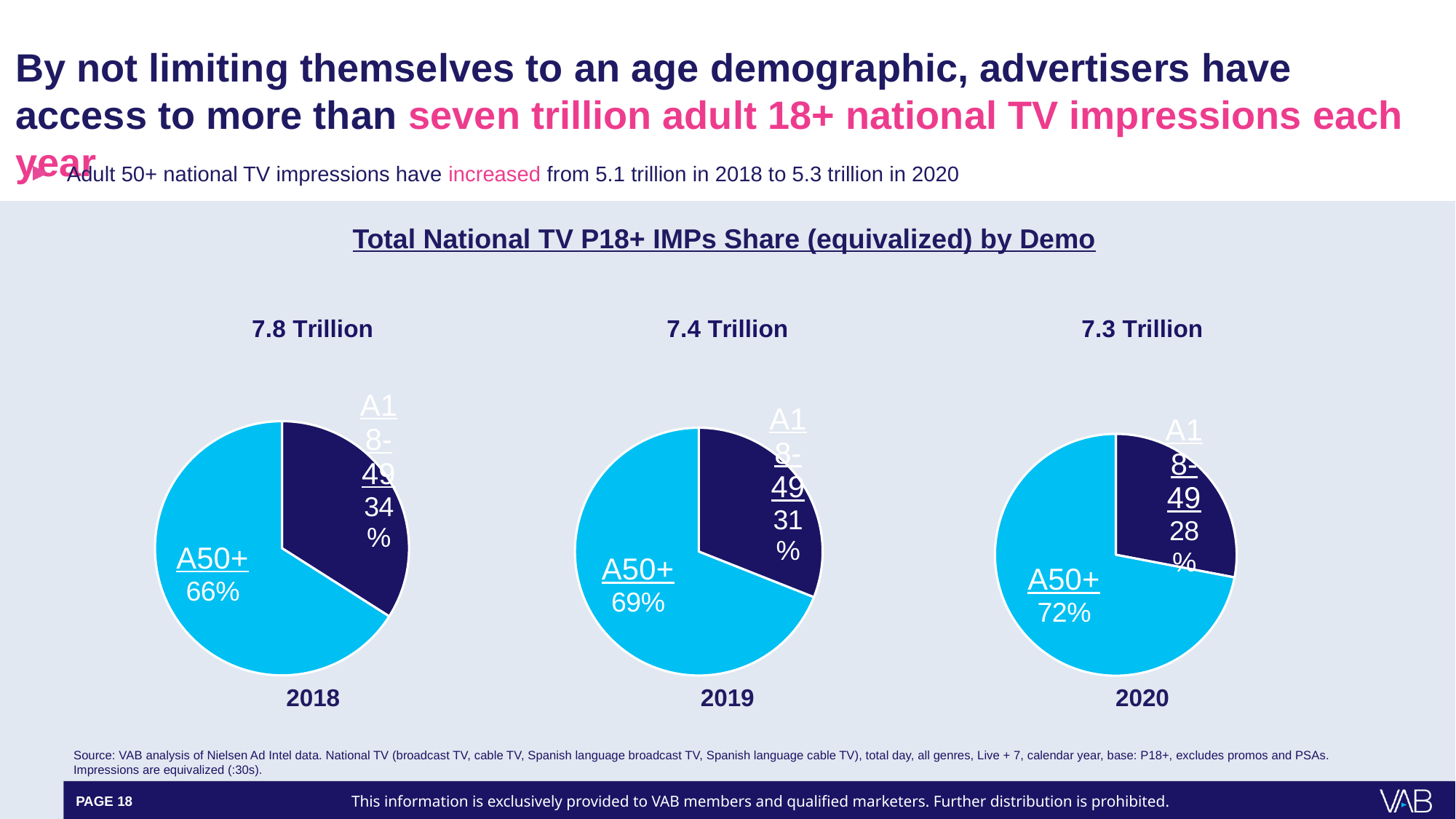
What is the title shown above the three pie charts? Total National TV P18+ IMPs Share (equivalized) by Demo In the 2020 pie chart, what share is shown for A50+? 72% In the 2020 pie chart, what is the difference in percentage points between the A50+ share and the A18-49 share? 44 In the 2018 pie chart, what share is shown for A50+? 66% Across the three pie charts, does the A50+ share rise or fall from 2018 to 2020? rise In the 2020 pie chart, what share is shown for A18-49? 28% What type of chart is used for the 2019 data? pie chart What total is shown above the 2019 pie chart? 7.4 Trillion In the 2018 pie chart, what share is shown for A18-49? 34% In the 2019 pie chart, what share is shown for A50+? 69% In the 2019 pie chart, which slice is larger, A18-49 or A50+? A50+ How many slices does the 2018 pie chart have? 2